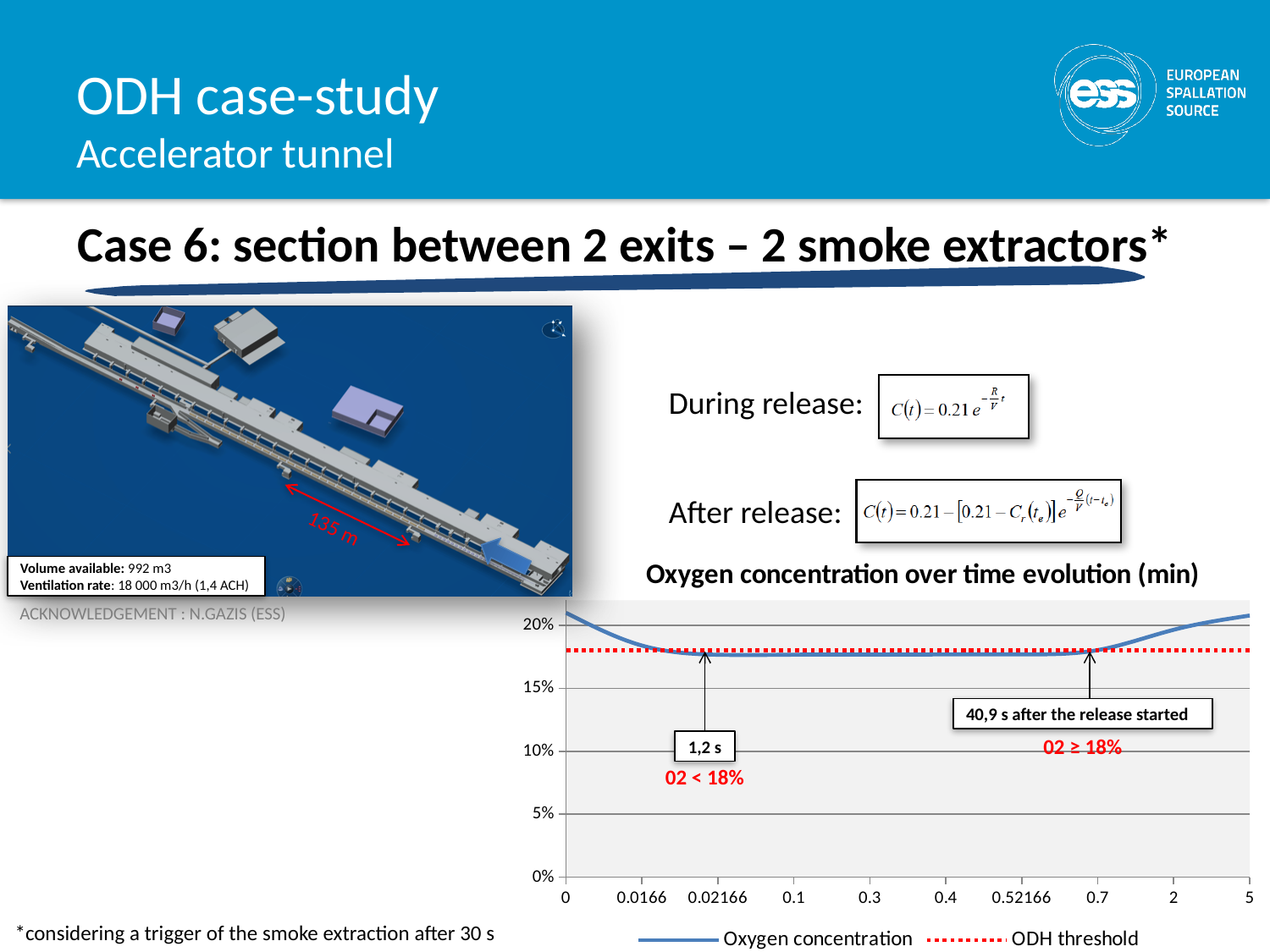
What kind of chart is shown on the slide? line chart According to the annotation, at what time does the oxygen concentration drop below 18%? 1,2 s How many series does the chart legend list? 2 Does the oxygen concentration rise or fall between x = 0 and x = 0.02166? fall What is the title of the chart? Oxygen concentration over time evolution (min) Does the oxygen concentration rise or fall between x = 0.7 and x = 5? rise Which two series are listed in the chart legend? Oxygen concentration and ODH threshold Is the oxygen concentration at x = 0 greater or less than 20%? greater Is the oxygen concentration at x = 0.3 greater or less than 20%? less How many tick labels are shown on the x axis of the chart? 10 According to the annotation, how long after the release started does the oxygen concentration return to at least 18%? 40,9 s Is the ODH threshold line greater or less than 15%? greater